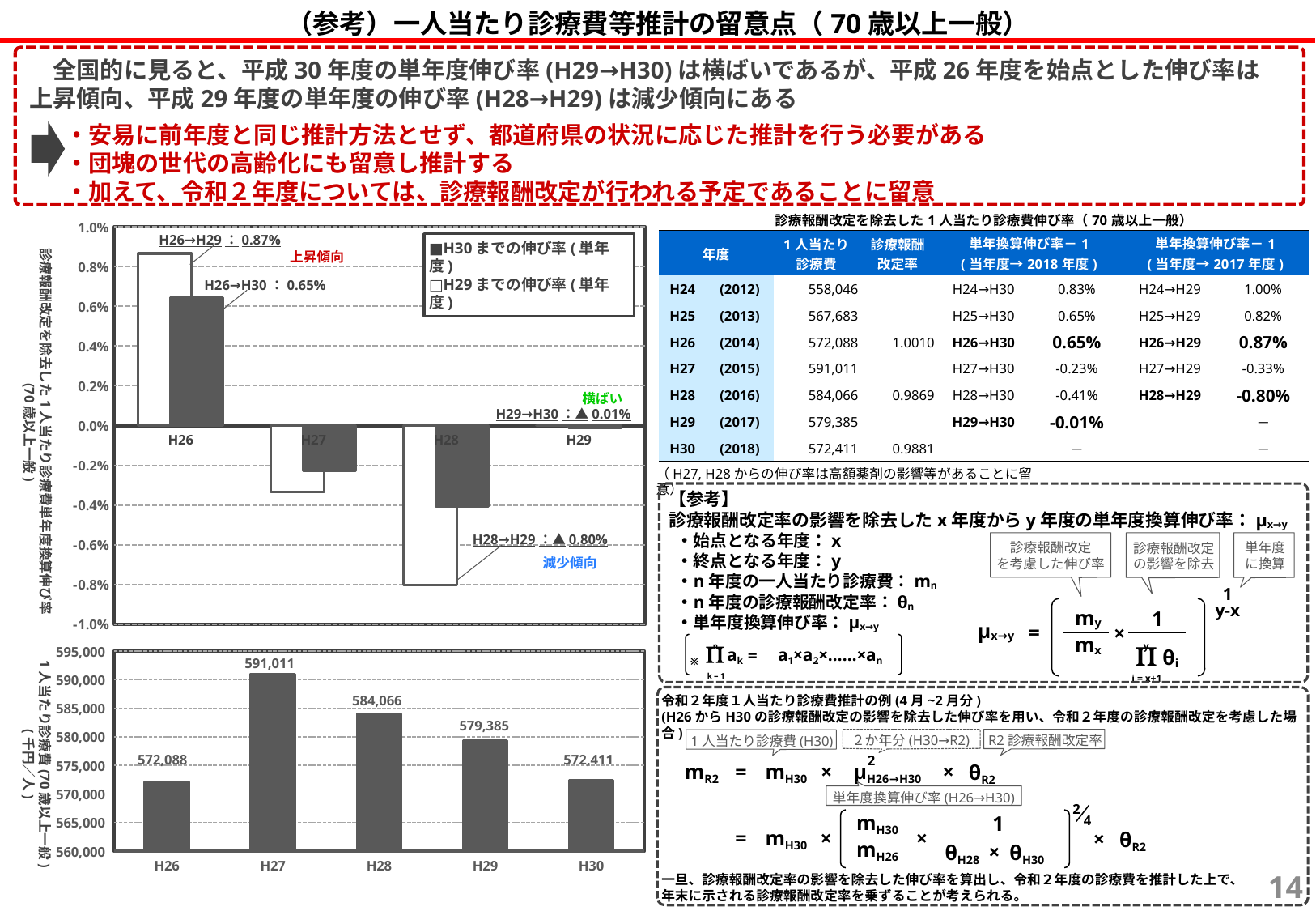
In the bottom chart (1人当たり診療費), what is the value for H29? 579,385 What type of chart is the top chart (growth rates)? Bar chart In the bottom chart (1人当たり診療費), what is the value for H27? 591,011 In the bottom chart (1人当たり診療費), which is larger, the value for H28 or the value for H30? H28 In the bottom chart (1人当たり診療費), which year has the lowest value? H26 In the top chart (growth rates), what is the labelled value for H26→H29? 0.87% In the top chart (growth rates), what is the labelled value for H28→H29? ▲0.80% In the bottom chart (1人当たり診療費), is the value for H29 greater or less than 575,000? greater In the bottom chart (1人当たり診療費), how many years are plotted? 5 In the bottom chart (1人当たり診療費), what is the difference between the H27 and H28 values? 6,945 In the top chart (growth rates), how many series does the legend list? 2 In the bottom chart (1人当たり診療費), which year has the highest value? H27